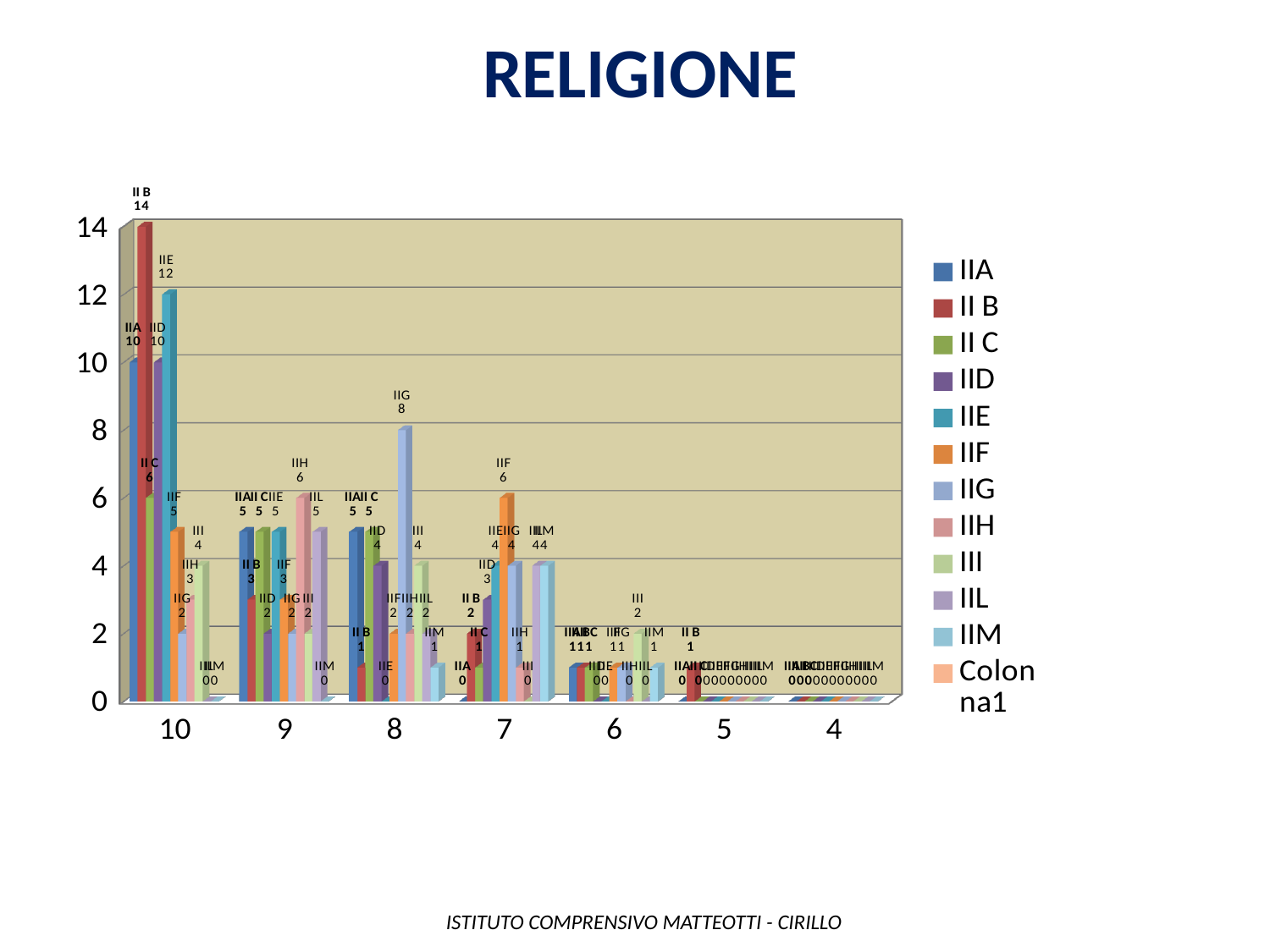
What is the value for II B in category 10? 14 Which series has the highest value in category 9? IIH How many series does the legend list? 12 What is the title of the chart? RELIGIONE What is the value for IIE in category 10? 12 Which is larger: the IIG value in category 8 or the IIF value in category 7? IIG in category 8 What type of chart is shown on the slide? bar chart How many categories are shown on the x axis? 7 What is the difference between the II B value and the IIE value in category 10? 2 Which series has the highest value in the whole chart? II B What is the value for IIG in category 8? 8 What is the value for IIF in category 7? 6